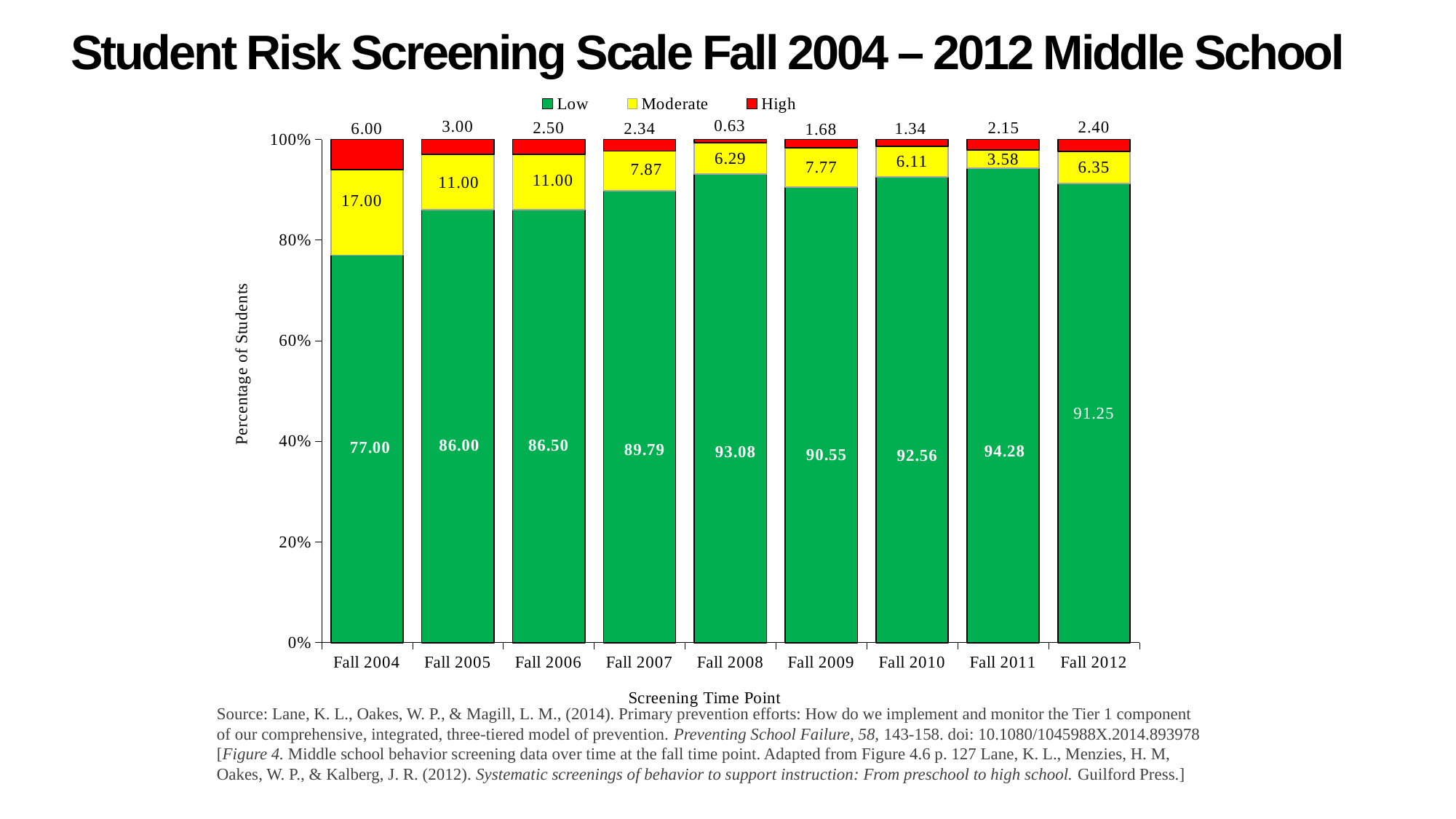
What is the difference between the Low values for Fall 2005 and Fall 2004? 9.00 How many screening time points are shown on the x axis? 9 Which screening time point has the highest Low value? Fall 2011 Which is larger, the Moderate value for Fall 2009 or for Fall 2010? Fall 2009 Which screening time point has the lowest High value? Fall 2008 How many series does the legend list? 3 What kind of chart is shown on the slide? Stacked bar chart What is the High value for Fall 2008? 0.63 Does the Low value rise or fall from Fall 2004 to Fall 2008? Rise What is the Moderate value for Fall 2007? 7.87 What is the Low value for Fall 2004? 77.00 What colour represents the High series in the chart? Red